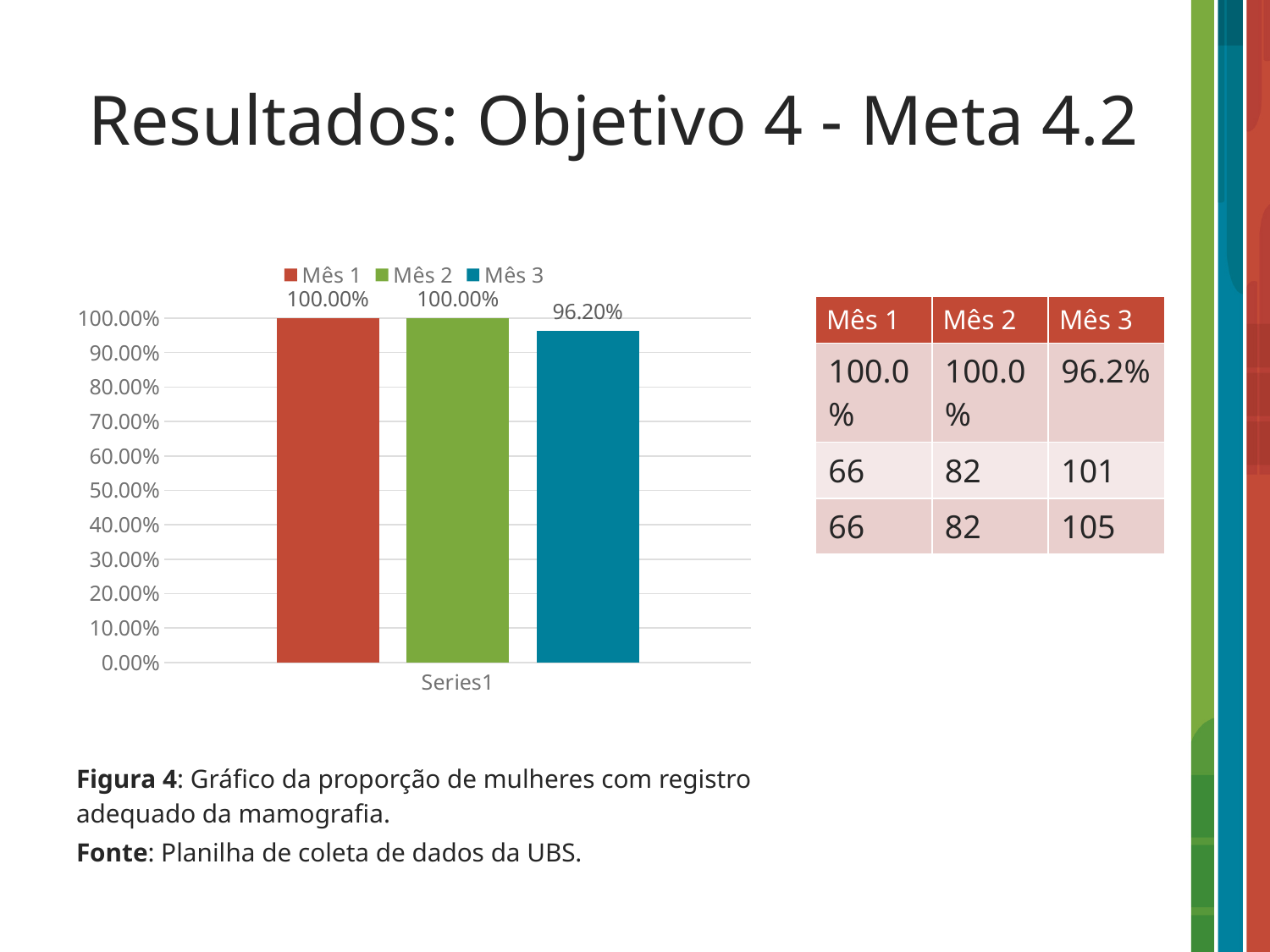
What is the difference between the values for Mês 1 and Mês 3? 3.80% Is the value for Mês 3 greater or less than 90.00%? greater What kind of chart is shown on the slide? bar chart What is the label on the category axis of the chart? Series1 How many series does the legend list? 3 Which series has the lowest value in the chart? Mês 3 Which is larger, the value for Mês 2 or the value for Mês 3? Mês 2 What colour is the bar for Mês 3? blue What is the value shown for Mês 2 in the chart? 100.00% Do the values rise or fall from Mês 2 to Mês 3? fall What is the value shown for Mês 1 in the chart? 100.00% What is the value shown for Mês 3 in the chart? 96.20%